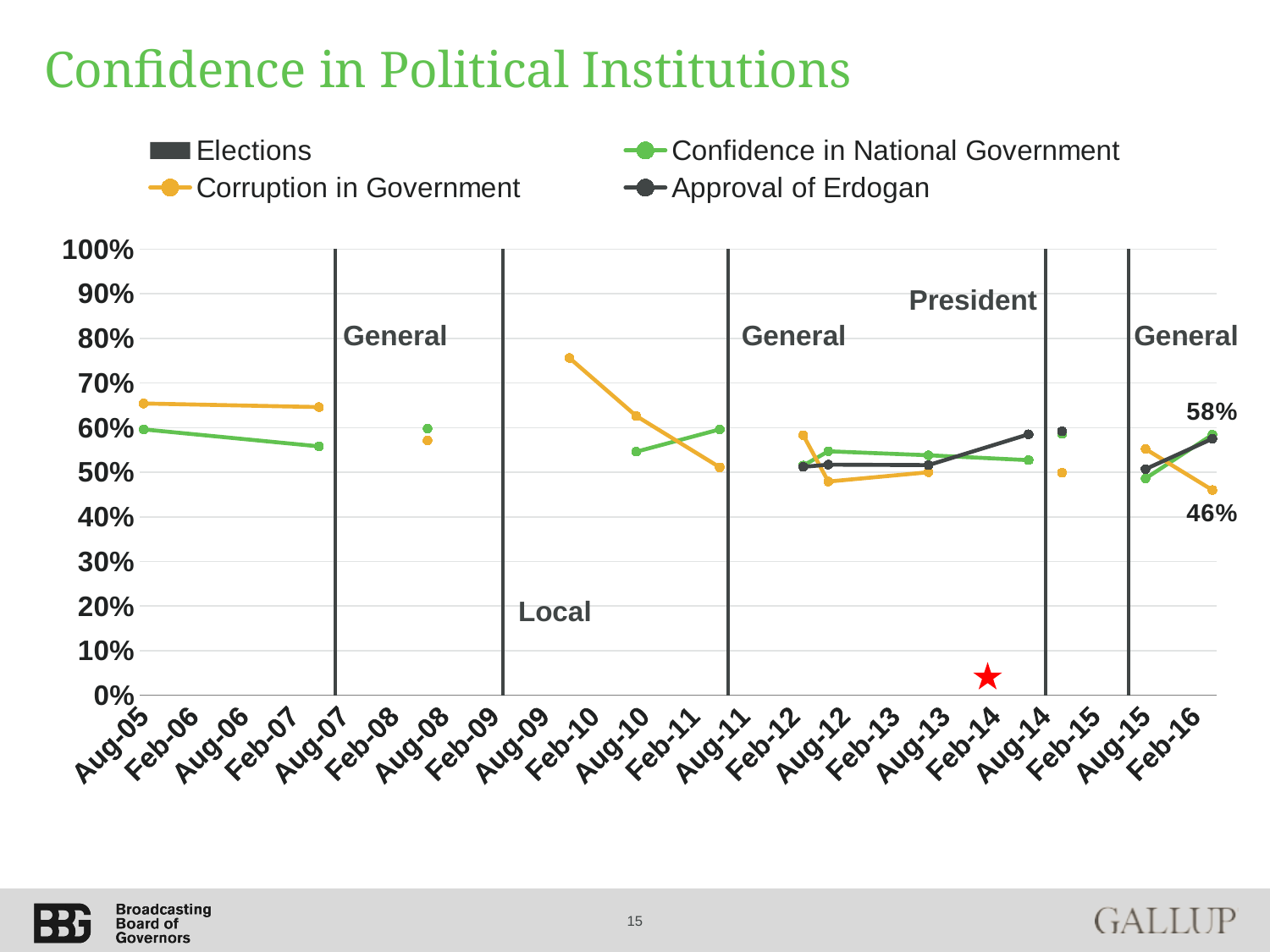
What is the highest data label printed on the chart? 58% Which series reaches the highest point on the chart? Corruption in Government How many entries does the legend list? 4 What is the value for Corruption in Government at Feb-16? 46% What is the difference between the two data labels printed at Feb-16 (58% and 46%)? 12 percentage points What kind of chart is shown on the slide? line chart Is the value for Confidence in National Government at Aug-15 greater or less than 60%? less At Feb-16, which is larger: Corruption in Government or Confidence in National Government? Confidence in National Government Does Corruption in Government rise or fall from Feb-10 to Feb-11? fall Is the value for Approval of Erdogan at Feb-14 greater or less than 50%? greater What is the title of the chart? Confidence in Political Institutions Is the value for Corruption in Government at Feb-10 greater or less than 70%? greater